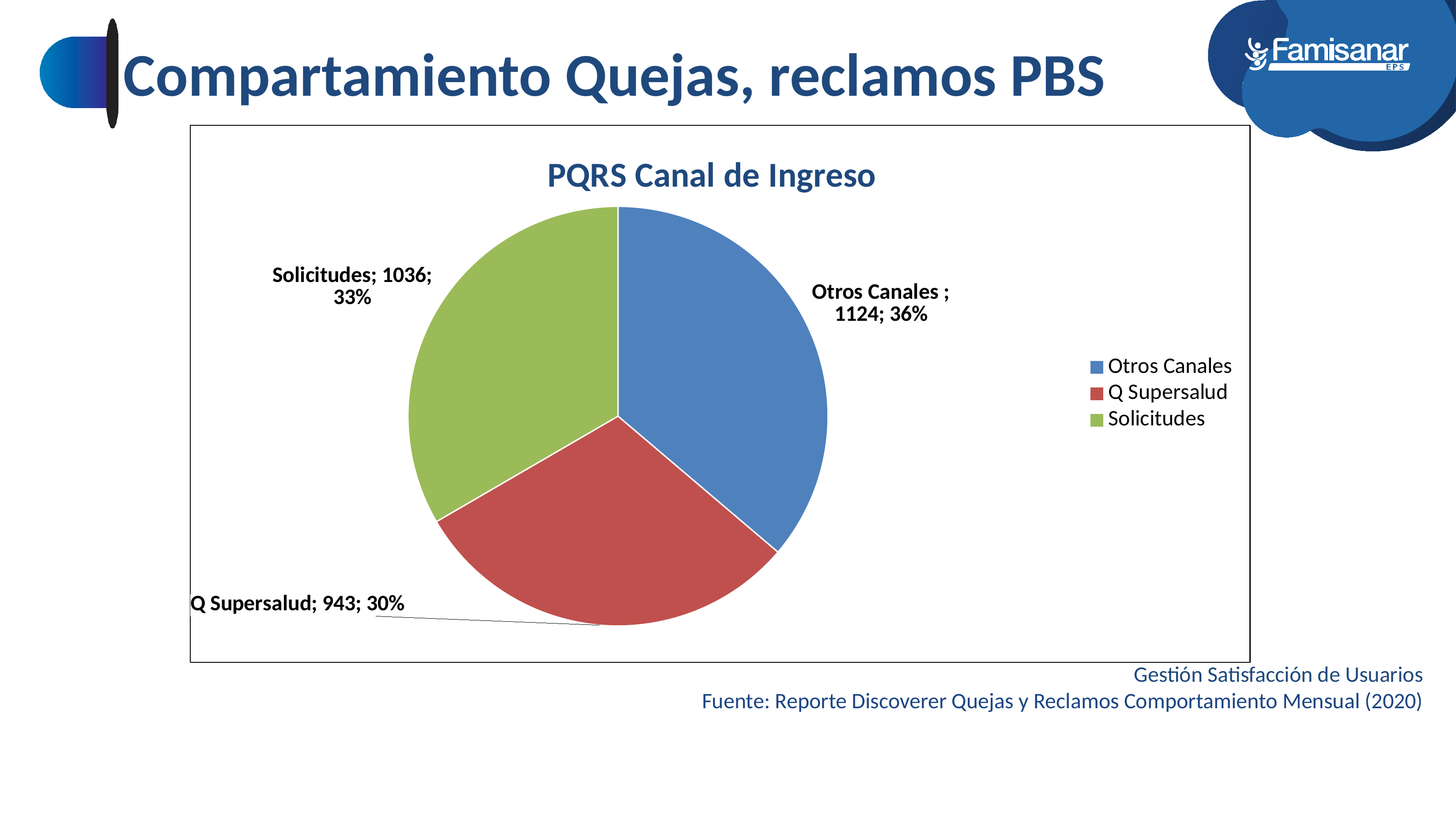
What is the value for Q Supersalud? 943 What type of chart is shown on the slide? pie chart Which category has the largest slice? Otros Canales What is the value for Otros Canales? 1124 Which colour represents Solicitudes in the legend? green What is the title of the chart? PQRS Canal de Ingreso Which category has the smallest slice? Q Supersalud How many categories does the pie chart show? 3 What is the difference between the values for Otros Canales and Q Supersalud? 181 What is the value for Solicitudes? 1036 What share of the pie does Q Supersalud represent? 30% What share of the pie does Solicitudes represent? 33%